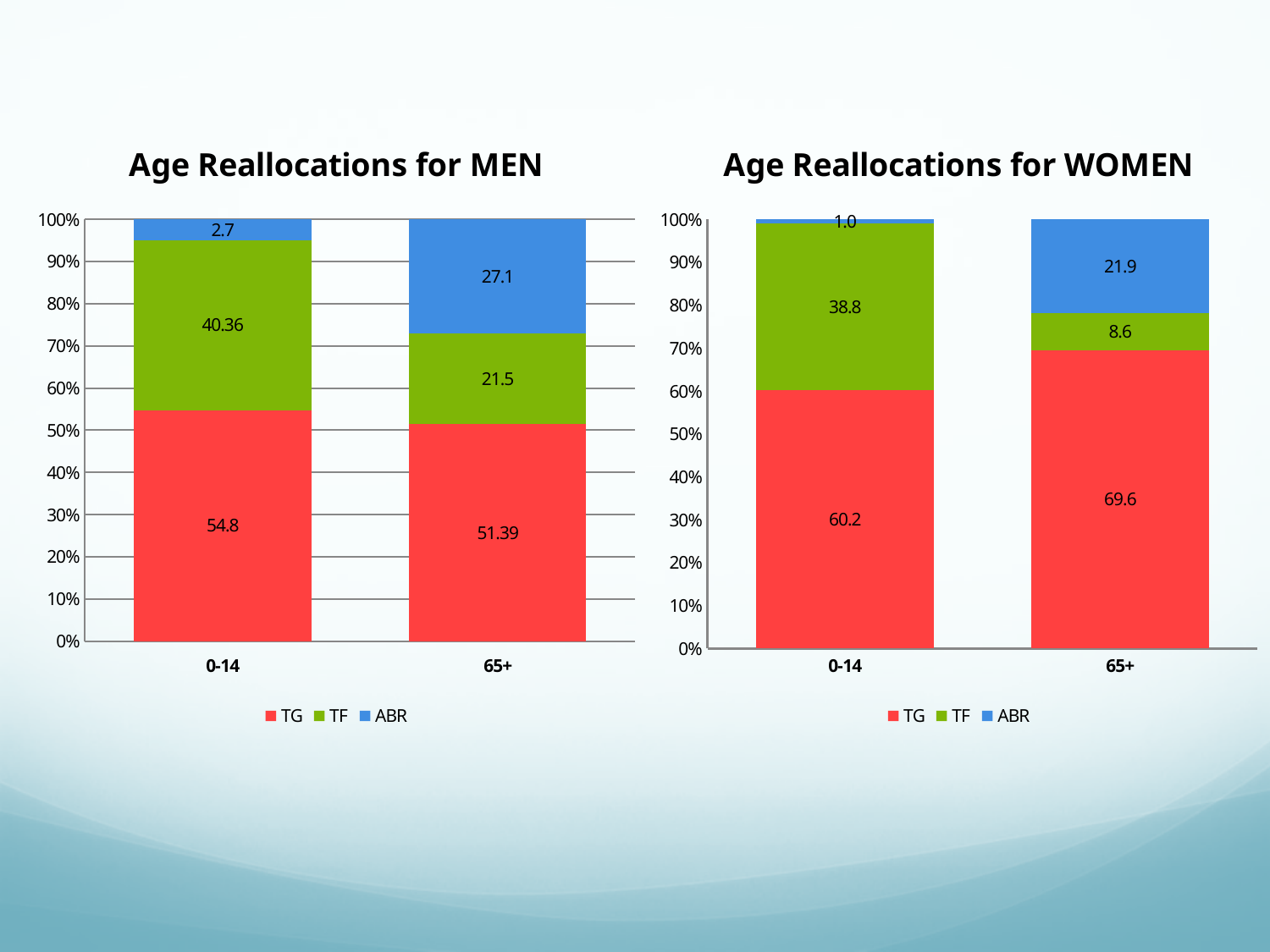
How many series does the legend of the 'Age Reallocations for MEN' chart list? 3 What kind of chart is 'Age Reallocations for MEN'? Stacked bar chart In the 'Age Reallocations for WOMEN' chart, what is the difference between the TG values for 65+ and 0-14? 9.4 In the 'Age Reallocations for MEN' chart, what is the TG value for the 0-14 age group? 54.8 In the 'Age Reallocations for WOMEN' chart, which series has the lowest value for the 0-14 group? ABR In the 'Age Reallocations for WOMEN' chart, which age group has the higher TF value? 0-14 In the 'Age Reallocations for MEN' chart, which is larger for the 65+ group: TF or ABR? ABR In the 'Age Reallocations for MEN' chart, what is the difference between the ABR values for 65+ and 0-14? 24.4 In the 'Age Reallocations for WOMEN' chart, what is the TG value for the 0-14 age group? 60.2 In the 'Age Reallocations for WOMEN' chart, what is the TF value for the 65+ age group? 8.6 In the 'Age Reallocations for MEN' chart, what is the ABR value for the 65+ age group? 27.1 How many age-group categories are shown on the x axis of the 'Age Reallocations for WOMEN' chart? 2